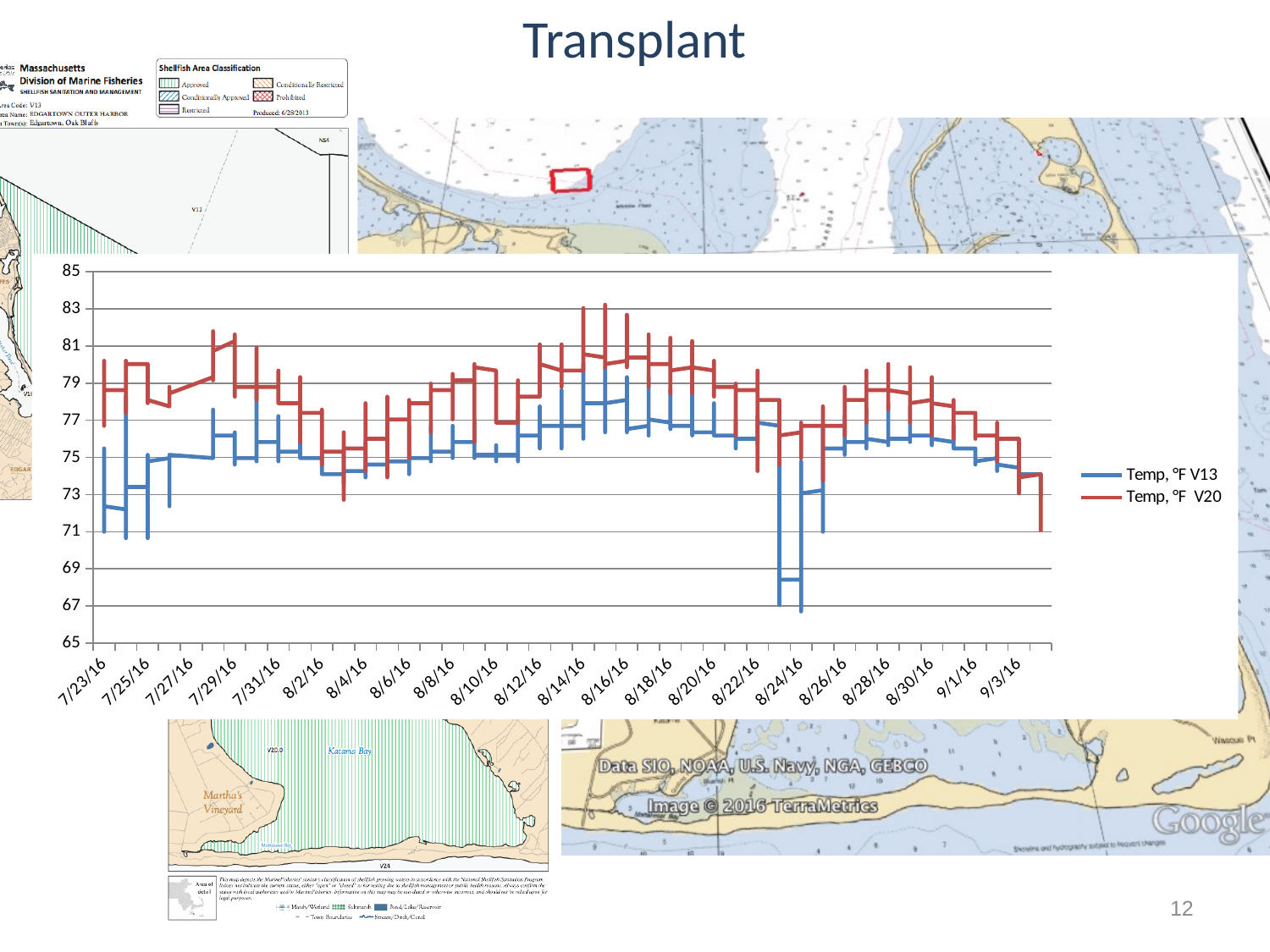
Does the Temp, °F V20 series rise or fall from 8/16/16 to 9/3/16? fall Is the value for Temp, °F V13 around 7/24/16 greater or less than 75? less Which series reaches the highest temperature on the chart? Temp, °F V20 What kind of chart is shown on the slide? line chart What are the minimum and maximum values shown on the vertical axis? 65 and 85 What are the two series named in the chart legend? Temp, °F V13 and Temp, °F V20 Is the value for Temp, °F V20 around 8/15/16 greater or less than 77? greater Which series is generally higher across the chart, Temp, °F V13 or Temp, °F V20? Temp, °F V20 How many series does the chart legend list? 2 Which series reaches the lowest temperature on the chart? Temp, °F V13 Which colour is used for the Temp, °F V20 series? red Is the lowest value for Temp, °F V13 (around 8/23/16) greater or less than 71? less